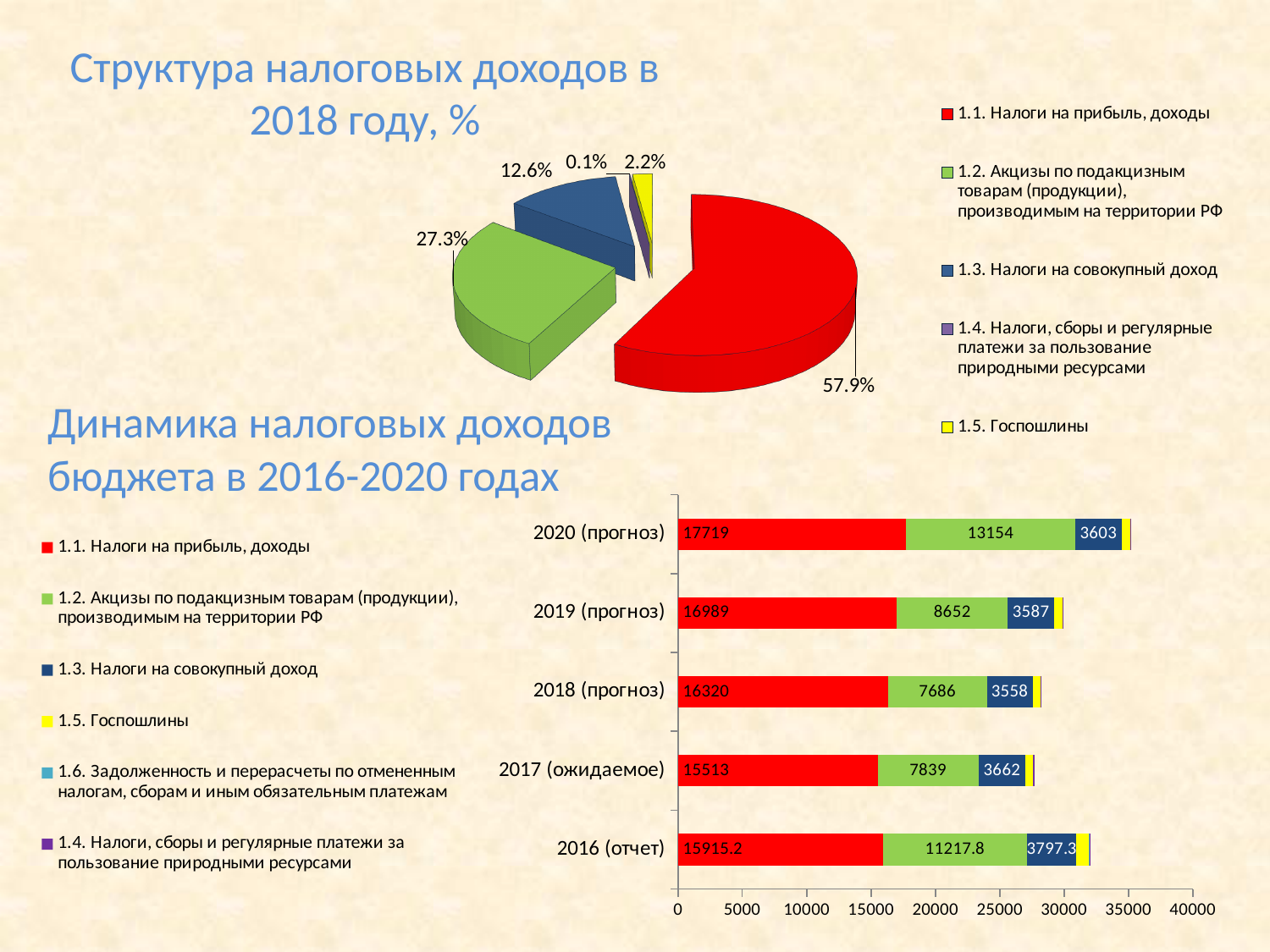
In the bar chart 'Динамика налоговых доходов бюджета в 2016-2020 годах', what is the value of '1.1. Налоги на прибыль, доходы' for '2020 (прогноз)'? 17719 In the pie chart 'Структура налоговых доходов в 2018 году, %', how many categories does the legend list? 5 In the bar chart 'Динамика налоговых доходов бюджета в 2016-2020 годах', what is the value of '1.3. Налоги на совокупный доход' for '2017 (ожидаемое)'? 3662 In the pie chart 'Структура налоговых доходов в 2018 году, %', what is the difference between the shares of '1.3. Налоги на совокупный доход' and '1.5. Госпошлины'? 10.4% In the bar chart 'Динамика налоговых доходов бюджета в 2016-2020 годах', which year has the highest value for '1.2. Акцизы по подакцизным товарам (продукции), производимым на территории РФ'? 2020 (прогноз) In the bar chart 'Динамика налоговых доходов бюджета в 2016-2020 годах', what is the value of '1.2. Акцизы по подакцизным товарам (продукции), производимым на территории РФ' for '2016 (отчет)'? 11217.8 In the pie chart 'Структура налоговых доходов в 2018 году, %', which category has the smallest share? 1.4. Налоги, сборы и регулярные платежи за пользование природными ресурсами In the pie chart 'Структура налоговых доходов в 2018 году, %', what share does '1.1. Налоги на прибыль, доходы' have? 57.9% What kind of chart is 'Динамика налоговых доходов бюджета в 2016-2020 годах'? Stacked bar chart In the bar chart 'Динамика налоговых доходов бюджета в 2016-2020 годах', how many years (categories) are shown? 5 In the bar chart 'Динамика налоговых доходов бюджета в 2016-2020 годах', what is the difference between the '1.1. Налоги на прибыль, доходы' values for '2019 (прогноз)' and '2018 (прогноз)'? 669 In the pie chart 'Структура налоговых доходов в 2018 году, %', what share does '1.2. Акцизы по подакцизным товарам (продукции), производимым на территории РФ' have? 27.3%